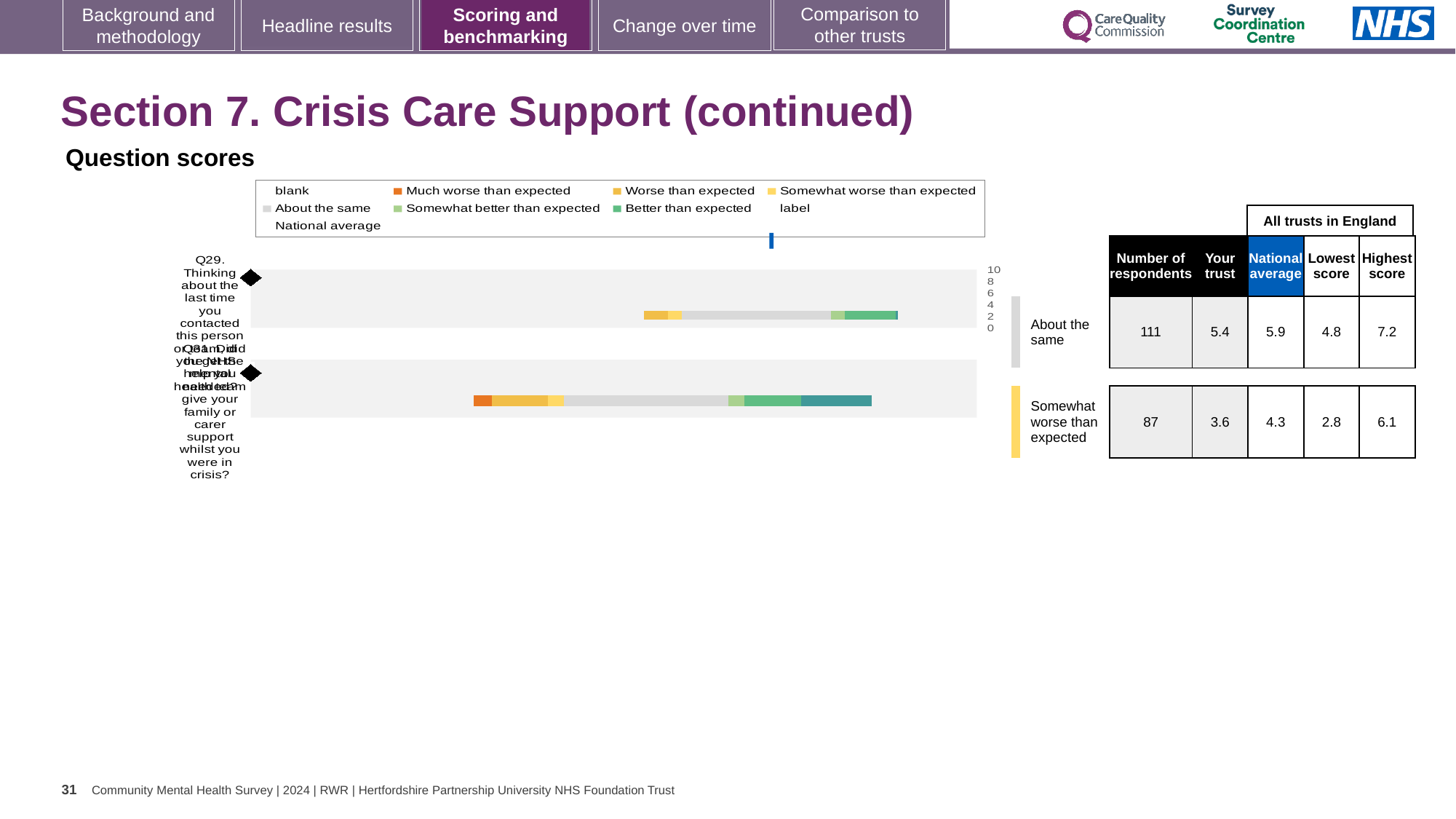
In the chart legend, what colour represents 'Better than expected'? green What kind of chart is shown under 'Question scores'? bar chart In the table beside the chart, what is the lowest score for the row labelled 'About the same'? 4.8 How many question bars are plotted in the chart? 2 In the table beside the chart, what is the 'Your trust' score for the row labelled 'Somewhat worse than expected'? 3.6 In the table beside the chart, what is the national average for the row labelled 'About the same'? 5.9 In the table beside the chart, what is the difference between the national average and the 'Your trust' score for the row labelled 'About the same'? 0.5 In the chart legend, what colour represents 'Much worse than expected'? orange In the table beside the chart, what is the number of respondents for the row labelled 'About the same'? 111 In the table beside the chart, what is the highest score for the row labelled 'Somewhat worse than expected'? 6.1 In the table beside the chart, which row has the larger 'Your trust' score: 'About the same' or 'Somewhat worse than expected'? About the same In the table beside the chart, what is the difference between the highest and lowest scores for the row labelled 'Somewhat worse than expected'? 3.3